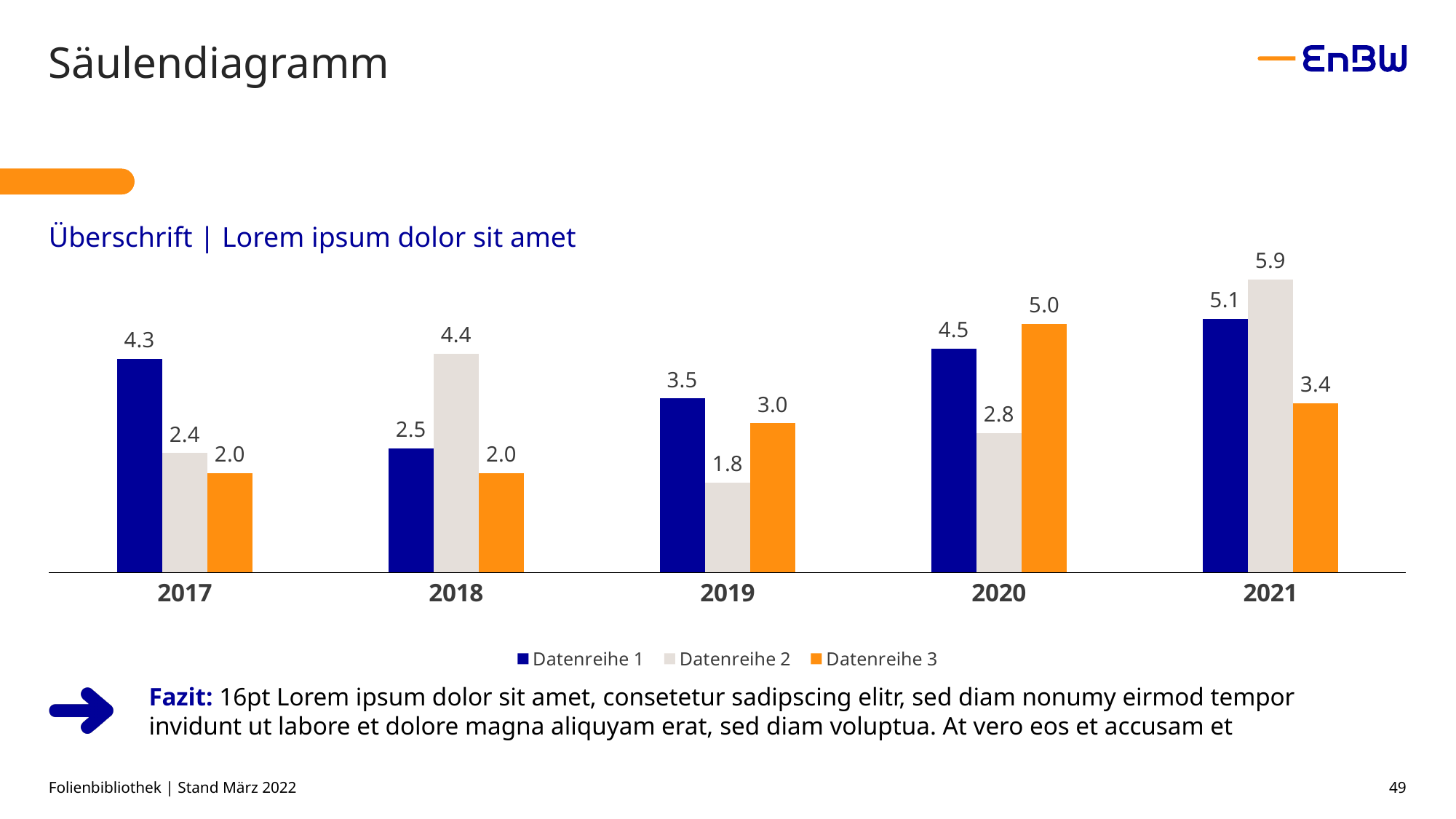
What is the value of Datenreihe 3 in 2020? 5.0 What is the difference between Datenreihe 2 and Datenreihe 1 in 2021? 0.8 What is the value of Datenreihe 2 in 2018? 4.4 In which year is Datenreihe 2 highest? 2021 Which is larger in 2019, Datenreihe 1 or Datenreihe 3? Datenreihe 1 In which year is Datenreihe 1 lowest? 2018 What is the value of Datenreihe 1 in 2017? 4.3 How many years are shown on the x axis? 5 What colour are the bars for Datenreihe 3? Orange What kind of chart is shown on the slide? Bar chart Does Datenreihe 3 rise or fall from 2019 to 2020? Rise How many series does the legend list? 3